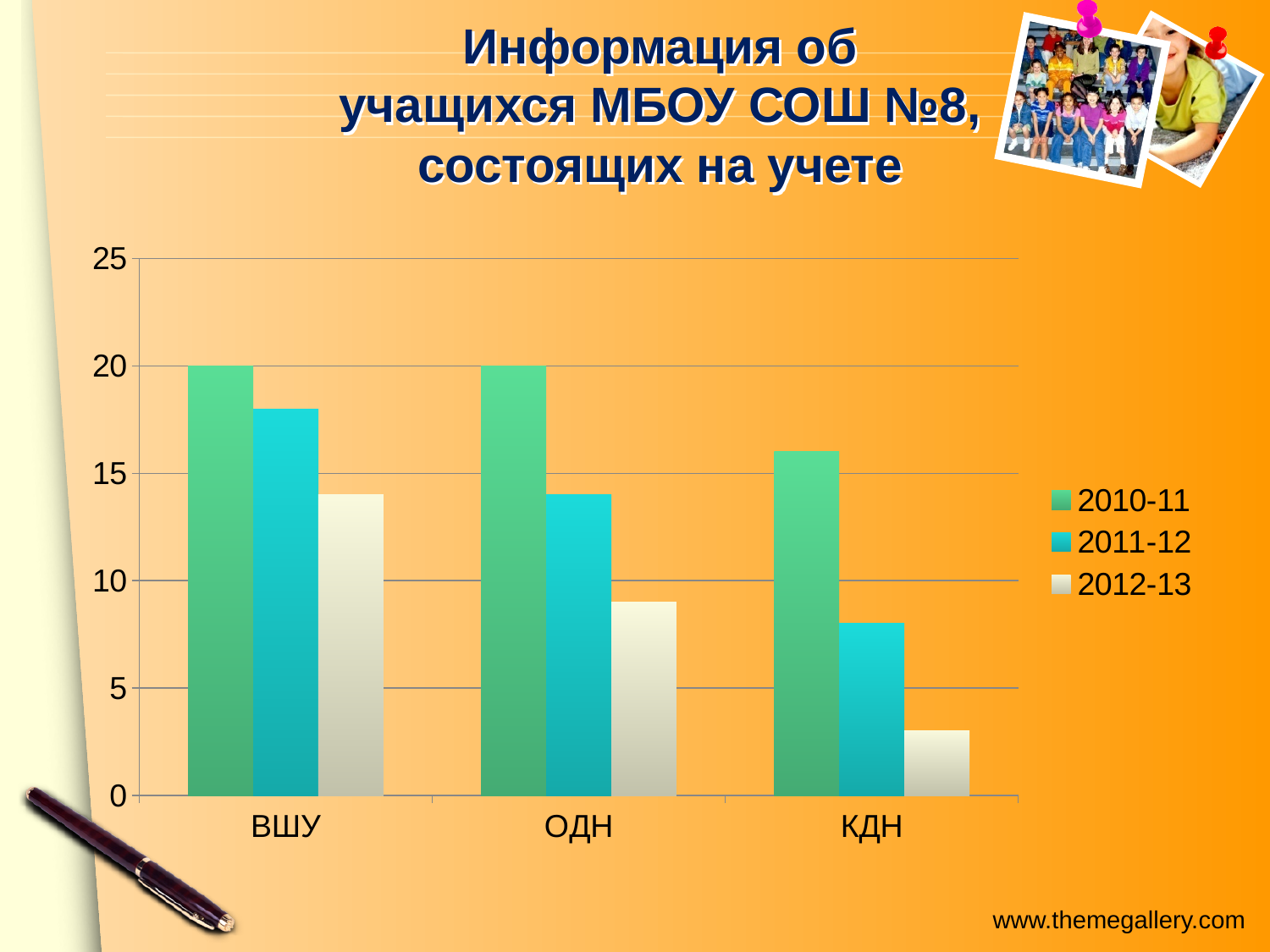
What is the value for ВШУ in the 2010-11 series? 20 Which series is shown in green in the legend? 2010-11 Which is larger for КДН: the 2010-11 value or the 2011-12 value? 2010-11 Which category has the lowest value in the 2012-13 series? КДН Do the values for КДН rise or fall from 2010-11 to 2012-13? fall Is the value for КДН in the 2012-13 series greater or less than 5? less How many series does the legend list? 3 What kind of chart is shown on the slide? bar chart What is the value for ОДН in the 2010-11 series? 20 Is the value for ОДН in the 2012-13 series greater or less than 10? less Is the value for ВШУ in the 2011-12 series greater or less than 15? greater How many categories are shown on the x axis? 3